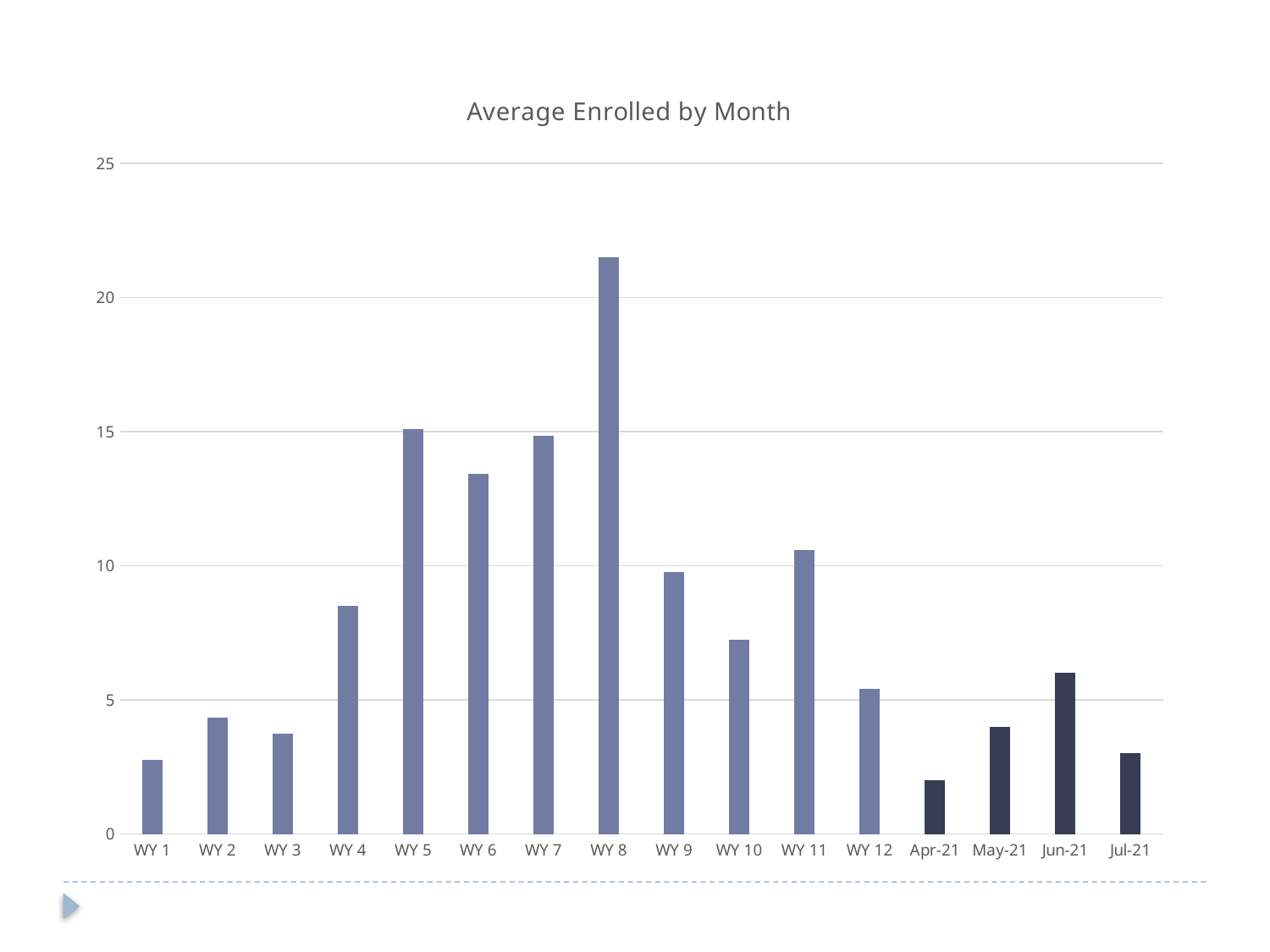
Is the value for Apr-21 greater or less than 5? less What type of chart is shown on the slide? bar chart How many categories are shown on the x axis? 16 What is the title of the chart? Average Enrolled by Month Which is larger, the value for May-21 or the value for Jun-21? Jun-21 Which category has the highest average enrolled? WY 8 Which is larger, the value for WY 5 or the value for WY 6? WY 5 Is the value for WY 4 greater or less than 10? less Which category has the lowest average enrolled? Apr-21 Is the value for WY 6 greater or less than 10? greater Which is larger, the value for WY 4 or the value for WY 10? WY 4